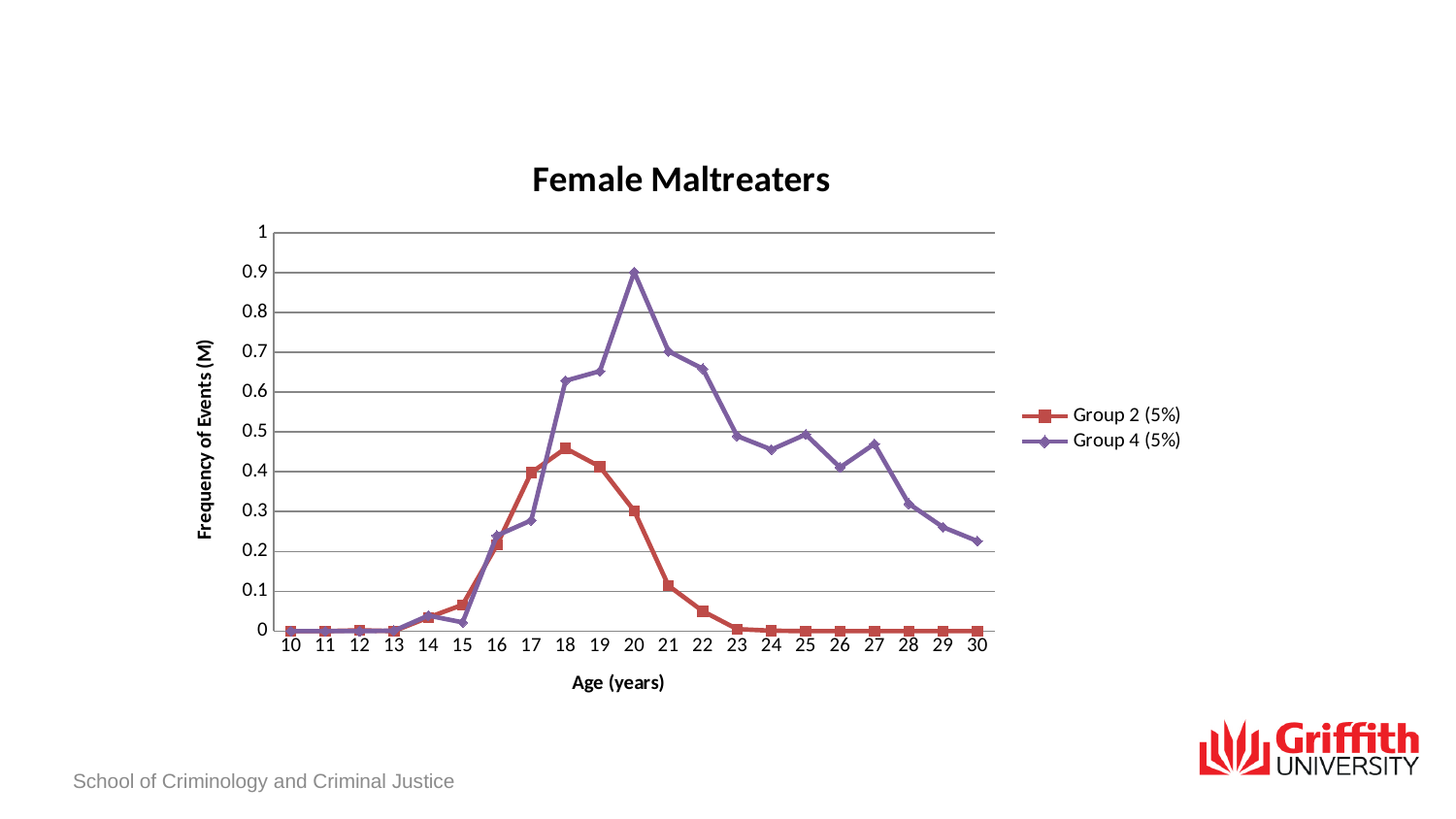
At which age does Group 4 (5%) reach its highest value? 20 At which age does Group 2 (5%) reach its highest value? 18 Is the value for Group 2 (5%) at age 18 greater or less than 0.5? less How many age points are plotted along the x axis? 21 How many series does the legend list? 2 At age 22, which series has the larger value, Group 2 (5%) or Group 4 (5%)? Group 4 (5%) Does the Group 2 (5%) line rise or fall between age 18 and age 23? fall What is the title of the chart? Female Maltreaters Is the value for Group 4 (5%) at age 30 greater or less than 0.3? less What kind of chart is shown on the slide? line chart What is the label of the y axis? Frequency of Events (M) Is the value for Group 4 (5%) at age 20 greater or less than 0.8? greater